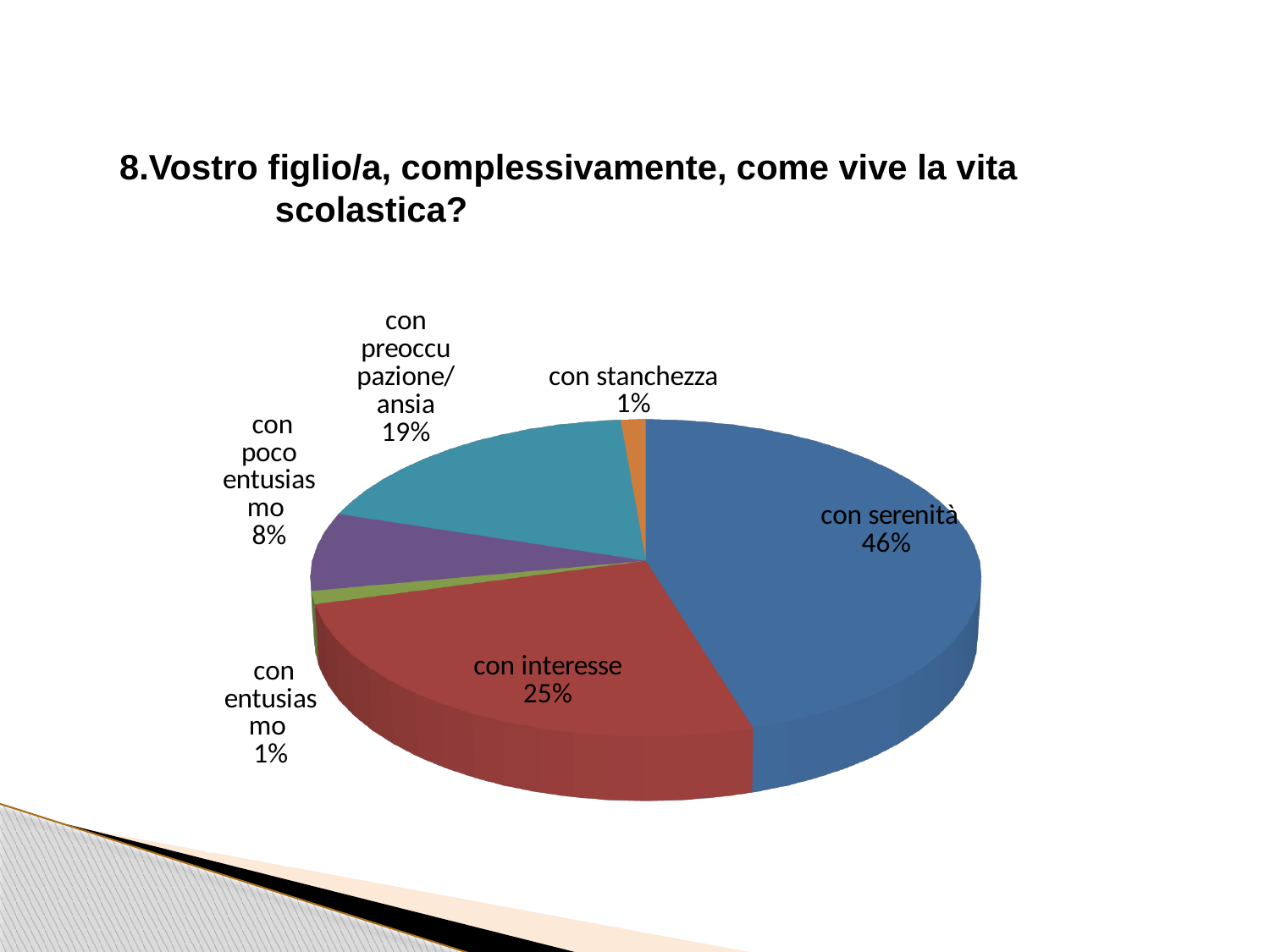
How many slices does the pie chart have? 6 What percentage of the pie is 'con preoccupazione/ansia'? 19% Which category has the largest share of the pie? con serenità What kind of chart is shown on the slide? pie chart Which is larger, 'con preoccupazione/ansia' or 'con poco entusiasmo'? con preoccupazione/ansia What percentage of the pie is 'con interesse'? 25% What is the combined share of 'con serenità' and 'con interesse'? 71% What percentage of the pie is 'con poco entusiasmo'? 8% What is the difference in percentage points between 'con serenità' and 'con interesse'? 21 What colour is the 'con serenità' slice? blue What percentage of the pie is 'con stanchezza'? 1% What percentage of the pie is 'con serenità'? 46%